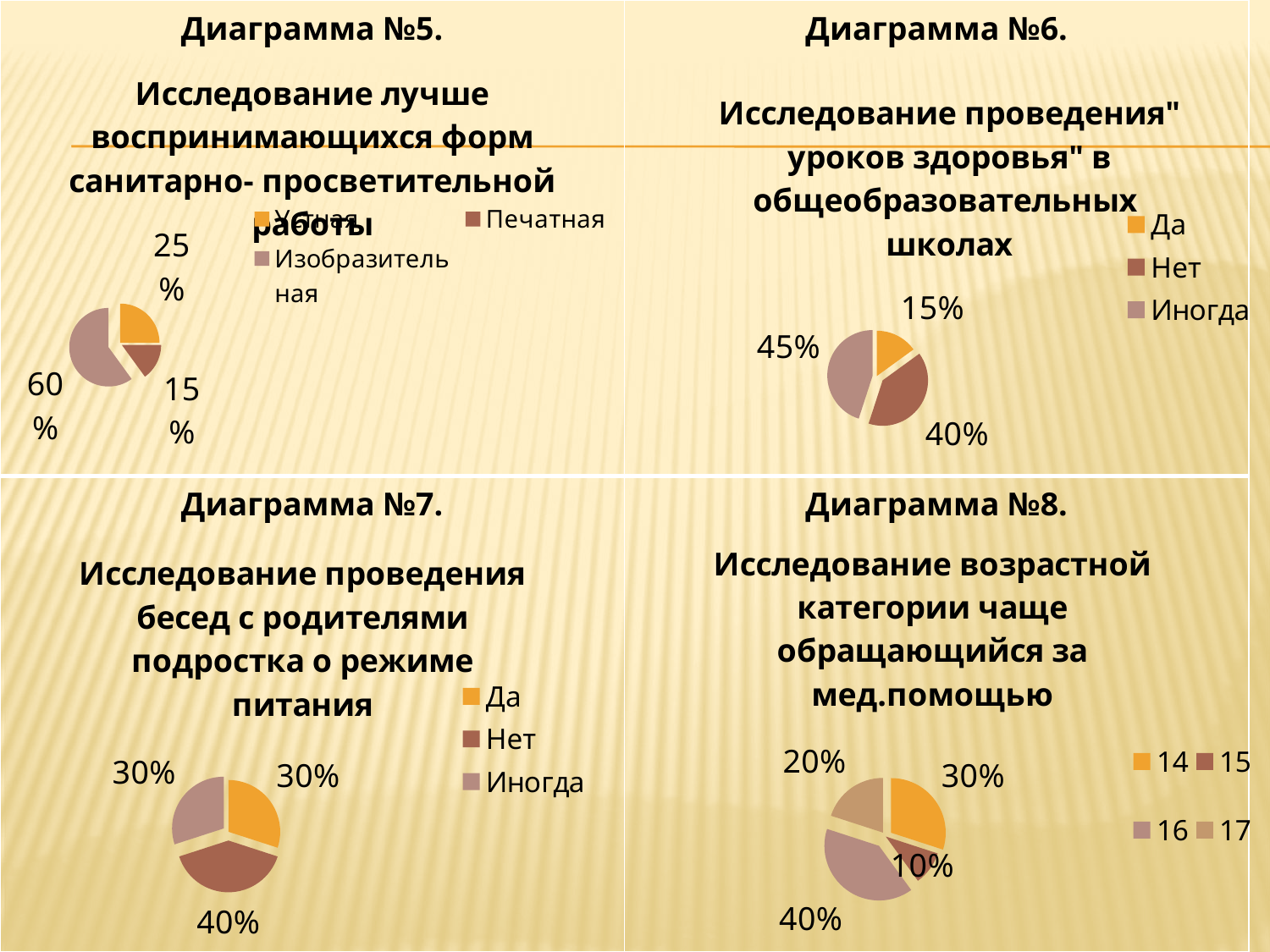
In Диаграмма №6, what share of the pie is labelled Нет? 40% In Диаграмма №6, what is the difference between the Иногда and Да shares? 30% What type of chart is Диаграмма №8? Pie chart In Диаграмма №7, what share is labelled Нет? 40% In Диаграмма №5, what share is labelled for Печатная? 15% In Диаграмма №8, which age category has the smallest slice? 15 In Диаграмма №8, how many categories does the pie have? 4 In Диаграмма №8, what share is labelled for age 16? 40% In Диаграмма №7, how many entries does the legend list? 3 In Диаграмма №6, which category has the smallest slice? Да In Диаграмма №6, which category has the largest slice? Иногда In Диаграмма №7, which category has the largest slice? Нет